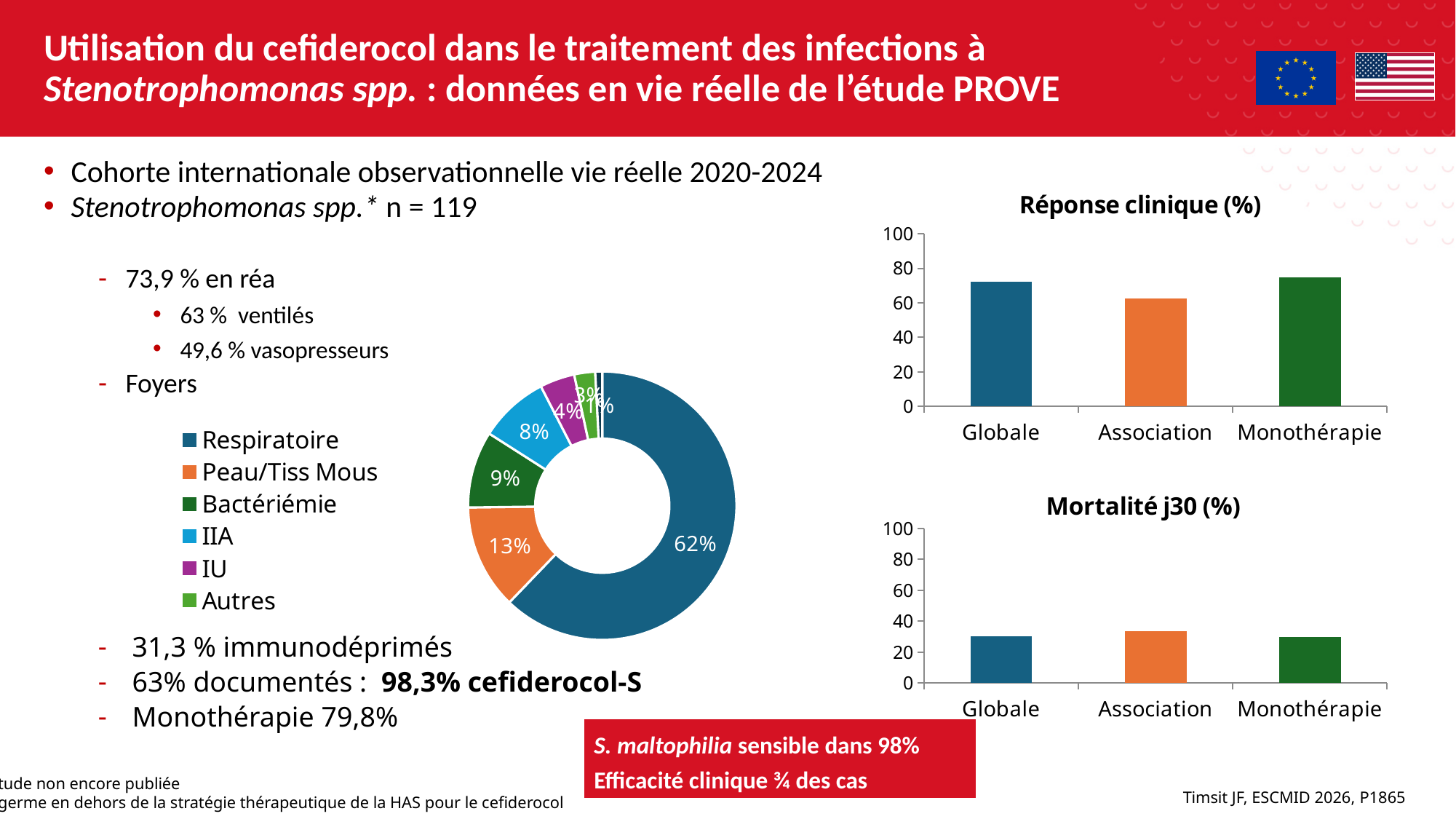
In the donut chart of infection sites (Foyers), how many categories does the legend list? 6 What kind of chart is the 'Mortalité j30 (%)' chart? bar chart In the 'Réponse clinique (%)' chart, which category has the lowest value? Association In the donut chart of infection sites (Foyers), what is the difference between the Respiratoire and Peau/Tiss Mous shares? 49% In the donut chart of infection sites (Foyers), what share is Respiratoire? 62% In the donut chart of infection sites (Foyers), which category has the largest share? Respiratoire In the donut chart of infection sites (Foyers), what share is IIA? 8% In the donut chart of infection sites (Foyers), what share is Bactériémie? 9% In the 'Mortalité j30 (%)' chart, is the value for Globale greater or less than 40? less In the 'Réponse clinique (%)' chart, is the value for Globale greater or less than 60? greater In the 'Réponse clinique (%)' chart, how many categories are shown on the x axis? 3 In the donut chart of infection sites (Foyers), what share is Peau/Tiss Mous? 13%